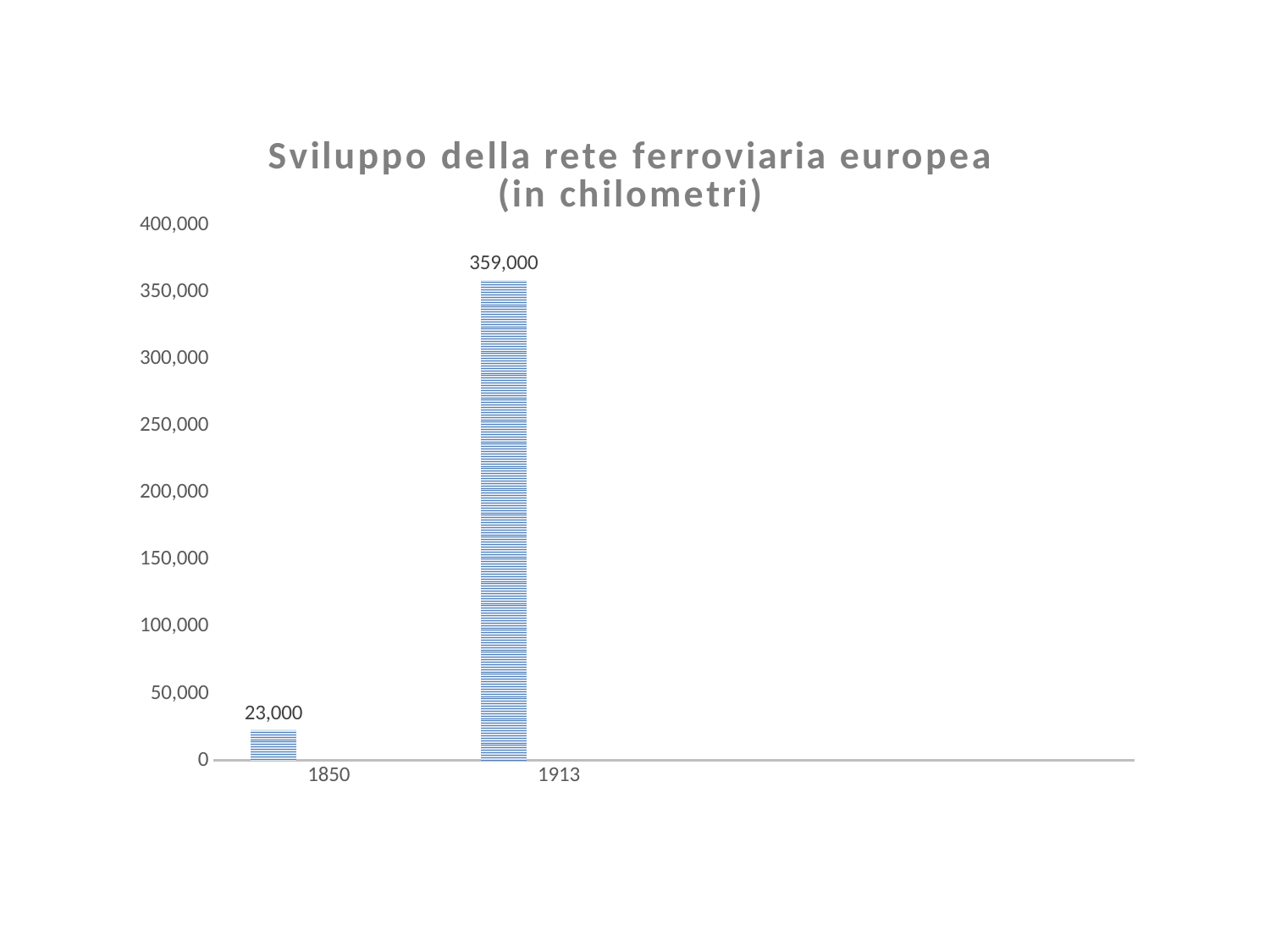
What kind of chart is shown on the slide? bar chart Do the values rise or fall from 1850 to 1913? rise What is the value for 1850? 23,000 Is the value for 1850 greater or less than 50,000? less What is the value for 1913? 359,000 What is the difference between the values for 1913 and 1850? 336,000 Which is larger, the value for 1850 or the value for 1913? 1913 Which year has the lowest value? 1850 Is the value for 1913 greater or less than 350,000? greater Which year has the highest value? 1913 How many categories are shown on the x axis? 2 What is the title of the chart? Sviluppo della rete ferroviaria europea (in chilometri)